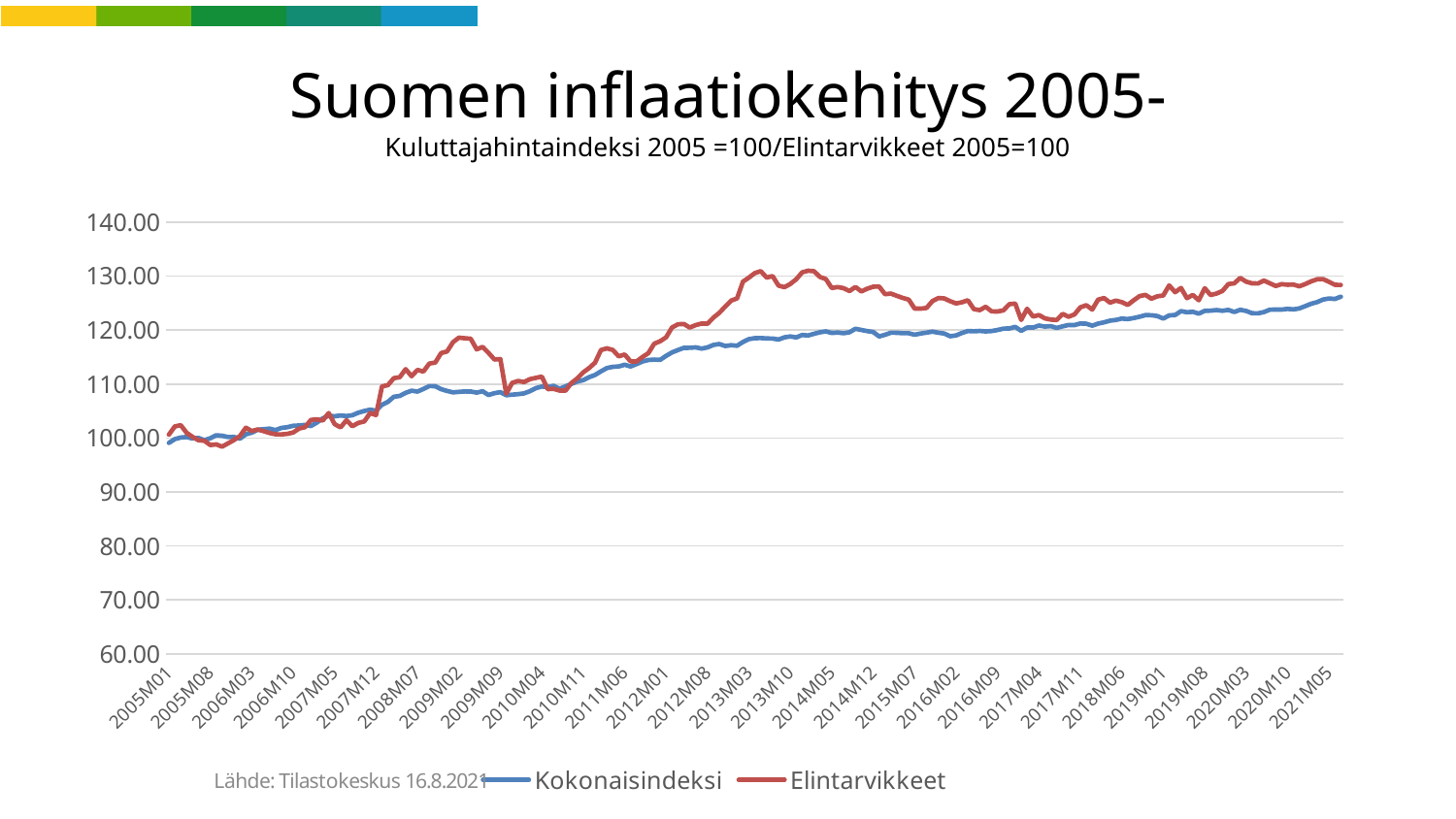
How many series does the legend list? 2 Does the Kokonaisindeksi series rise or fall overall from 2005M01 to 2021M05? rise Is the value of Kokonaisindeksi at 2021M05 greater or less than 120? greater Does the Elintarvikkeet series rise or fall between 2013M10 and 2017M04? fall What is the title of the chart? Suomen inflaatiokehitys 2005- What kind of chart is shown on the slide? line chart Is the value of Elintarvikkeet at 2009M02 greater or less than 110? greater What are the two series named in the legend? Kokonaisindeksi and Elintarvikkeet Which series reaches the highest value anywhere on the chart? Elintarvikkeet At 2013M10, which series has the higher value, Kokonaisindeksi or Elintarvikkeet? Elintarvikkeet Is the value of Kokonaisindeksi at 2007M05 greater or less than 110? less